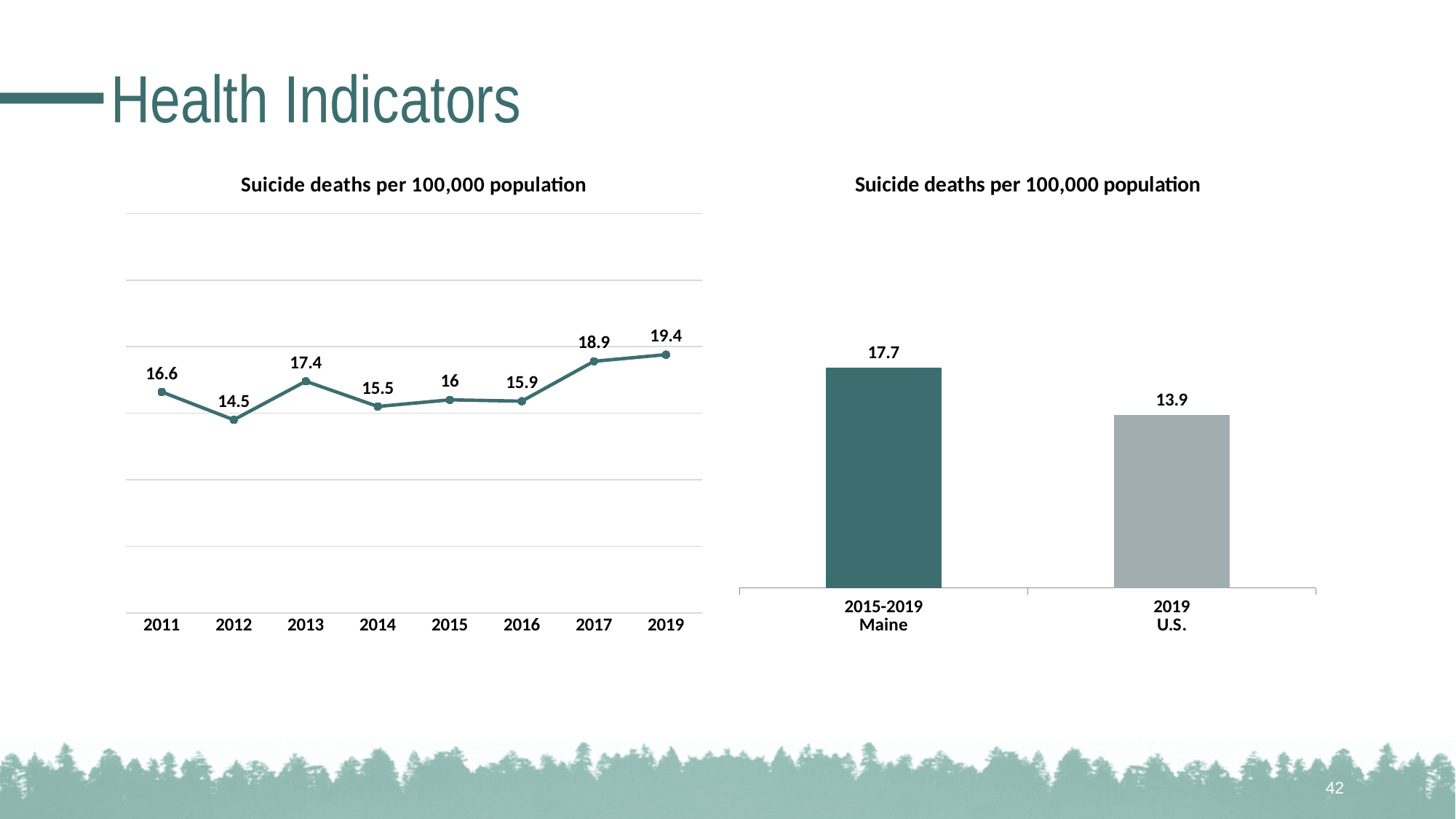
What is the title of the bar chart on the right? Suicide deaths per 100,000 population How many data points are plotted in the line chart on the left? 8 In the bar chart on the right, what is the difference between the Maine value and the U.S. value? 3.8 In the line chart on the left, which is larger, the value for 2014 or the value for 2017? 2017 In the bar chart on the right, what is the value for 2015-2019 Maine? 17.7 In the line chart on the left, what is the difference between the 2019 value and the 2011 value? 2.8 In the line chart on the left, what is the value for 2013? 17.4 What kind of chart is the chart on the right? bar chart In the line chart on the left, what is the value for 2019? 19.4 In the line chart on the left, which year has the highest value? 2019 What kind of chart is the chart on the left? line chart In the line chart on the left, which year has the lowest value? 2012